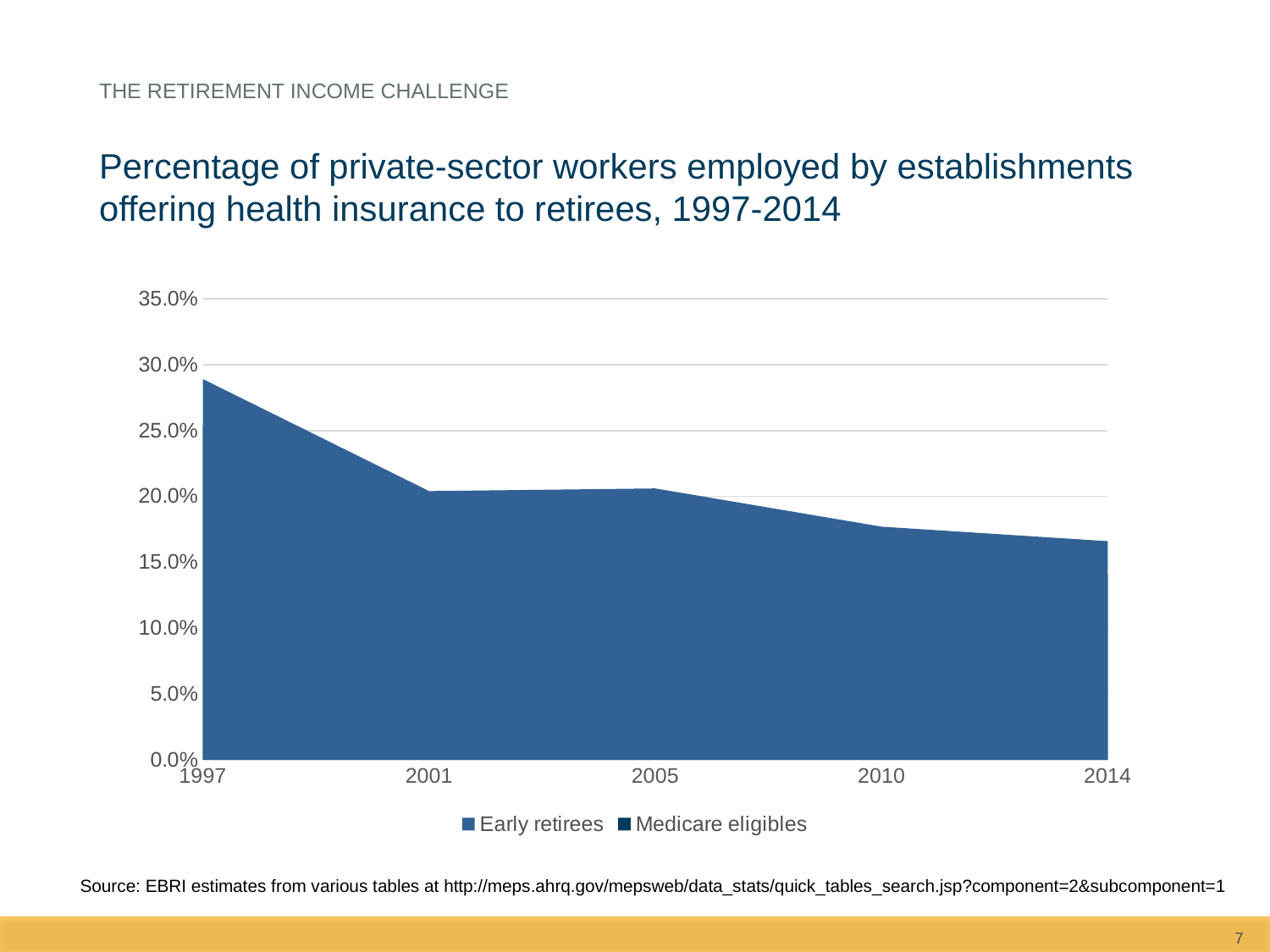
Is the plotted value for 2014 greater or less than 20.0%? less In which year is the plotted value highest? 1997 Does the plotted value rise or fall from 1997 to 2014? Fall What are the two series named in the legend? Early retirees and Medicare eligibles What is the highest value labelled on the y axis? 35.0% Which year has the larger plotted value, 1997 or 2014? 1997 Is the plotted value for 2010 greater or less than 20.0%? less What kind of chart is shown on the slide? Area chart How many years are labelled on the x axis? 5 In which year is the plotted value lowest? 2014 Is the plotted value for 1997 greater or less than 25.0%? greater How many series does the legend list? 2